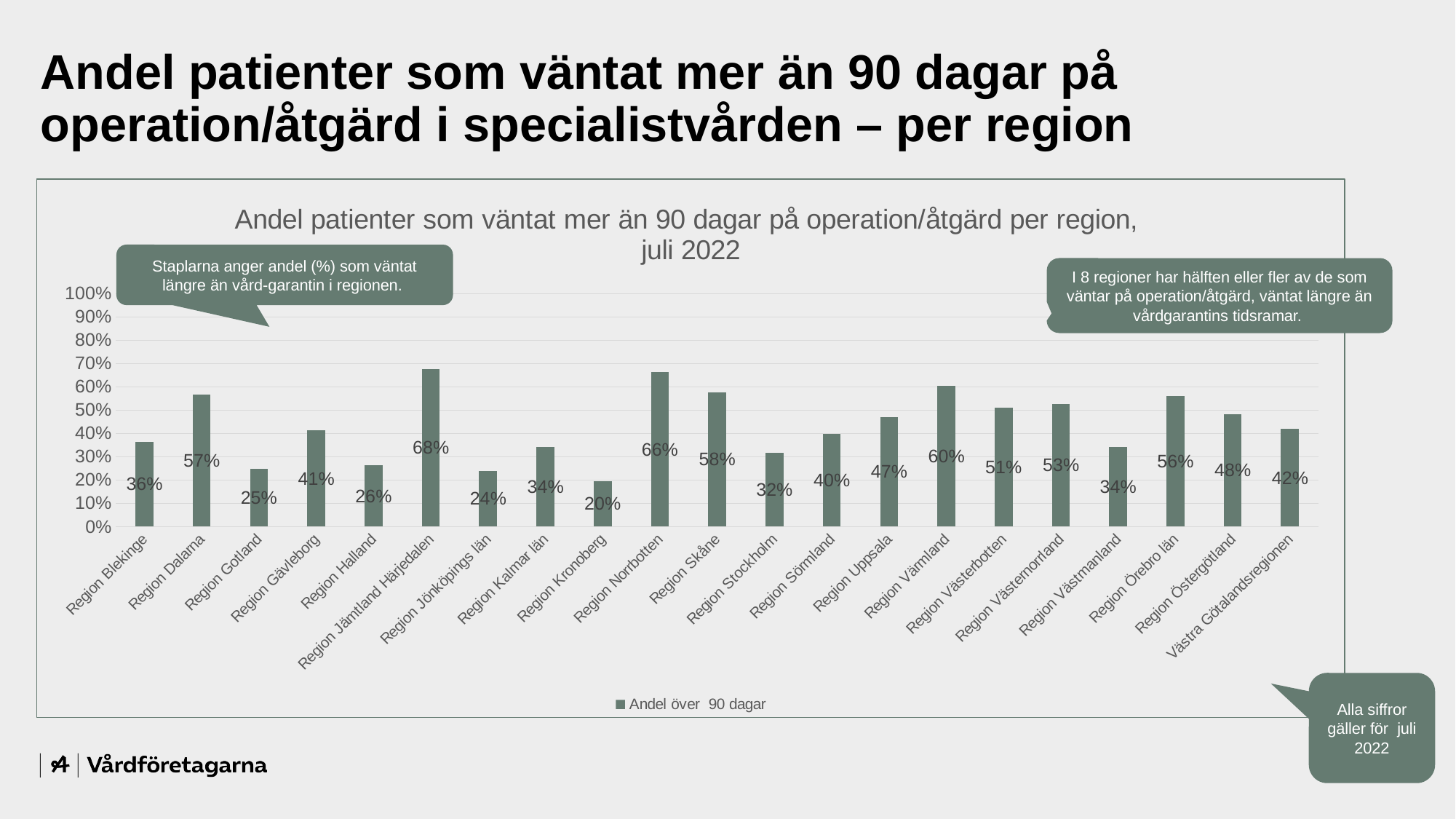
What is the legend entry for the series? Andel över 90 dagar How many regions are shown on the x axis? 21 What is the value for Region Kronoberg? 20% Which region has the highest value? Region Jämtland Härjedalen Which is larger, the value for Region Dalarna or the value for Region Gävleborg? Region Dalarna Is the value for Region Värmland greater or less than 50%? greater What is the value for Region Skåne? 58% What is the value for Region Västernorrland? 53% What kind of chart is shown? Bar chart What is the difference between the values for Region Norrbotten and Region Stockholm? 34% How many series does the legend list? 1 Which region has the lowest value? Region Kronoberg